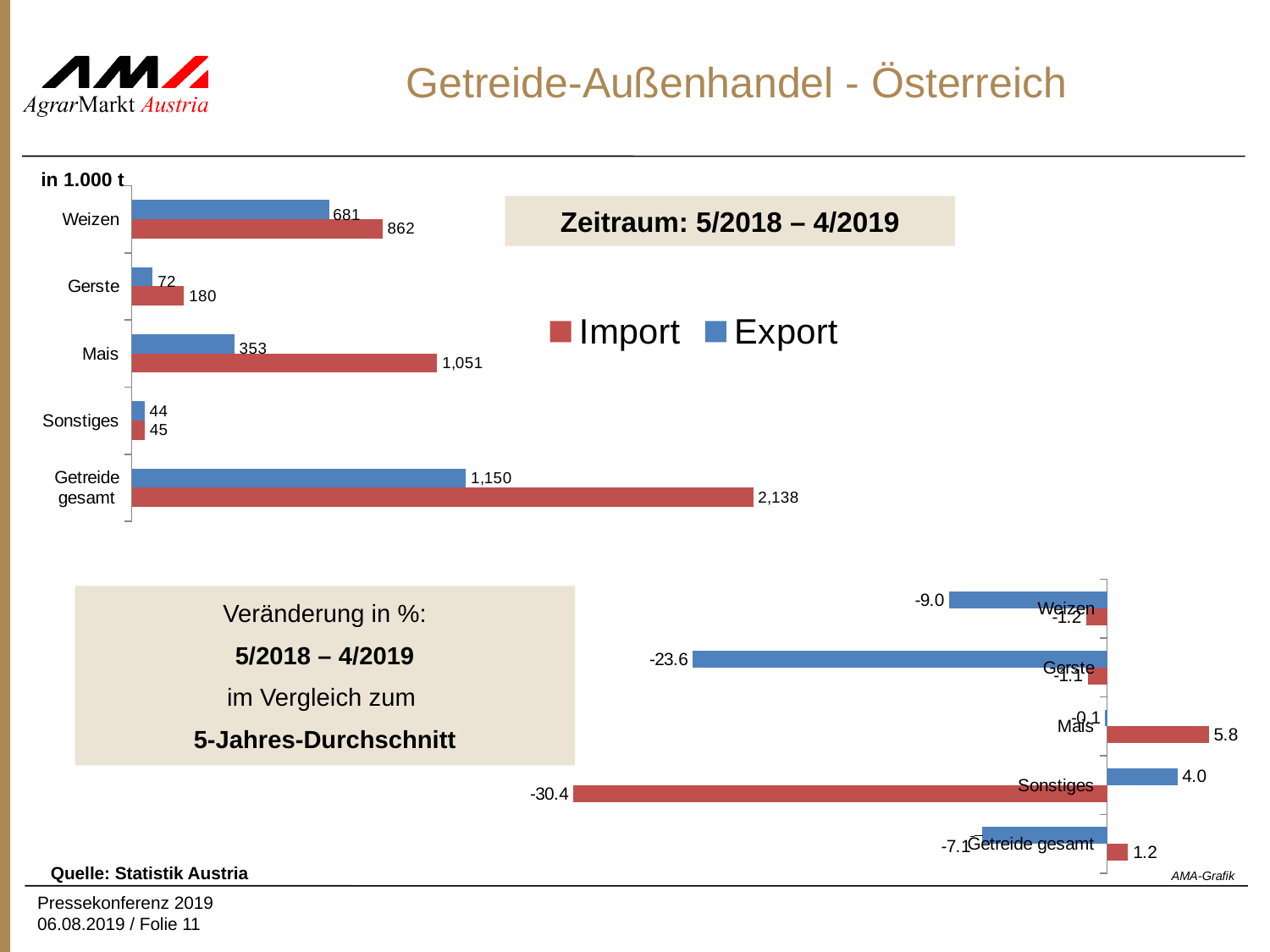
What type of chart is the top chart (in 1.000 t)? bar chart In the bottom chart (Veränderung in %), what is the Export value for Gerste? -23.6 In the top chart (in 1.000 t), is the Import or the Export value larger for Weizen? Import In the top chart (in 1.000 t), what is the Import value for Getreide gesamt? 2,138 How many categories are shown in the top chart (in 1.000 t)? 5 How many series does the legend of the top chart list? 2 In the top chart (in 1.000 t), what is the Export value for Weizen? 681 In the bottom chart (Veränderung in %), what is the Import value for Sonstiges? -30.4 In the bottom chart (Veränderung in %), which category has the highest Import value? Mais In the top chart (in 1.000 t), what is the Import value for Mais? 1,051 In the top chart (in 1.000 t), which category has the lowest Export value? Sonstiges In the top chart (in 1.000 t), what is the difference between Import and Export for Gerste? 108